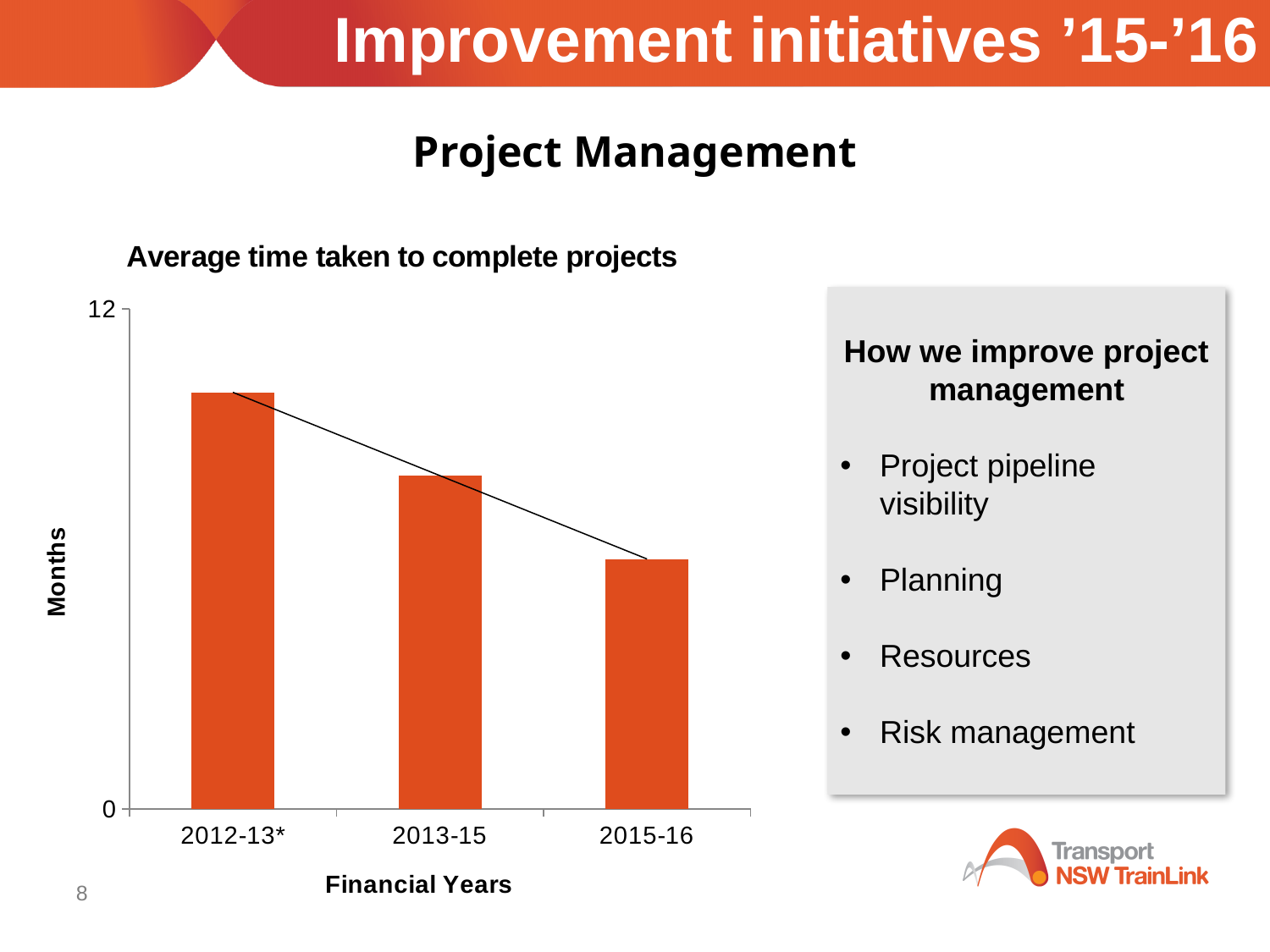
Which financial year has the highest average time taken to complete projects? 2012-13* Do the values rise or fall from 2012-13* to 2015-16? Fall Which financial year has the lowest average time taken to complete projects? 2015-16 Which is larger, the value for 2012-13* or the value for 2013-15? 2012-13* Is the value for 2012-13* greater or less than 12? less What kind of chart is shown on the slide? Bar chart What is the label on the vertical axis of the chart? Months Which is larger, the value for 2013-15 or the value for 2015-16? 2013-15 What is the title of the chart? Average time taken to complete projects How many financial years are plotted in the chart? 3 Is the value for 2015-16 greater or less than 12? less